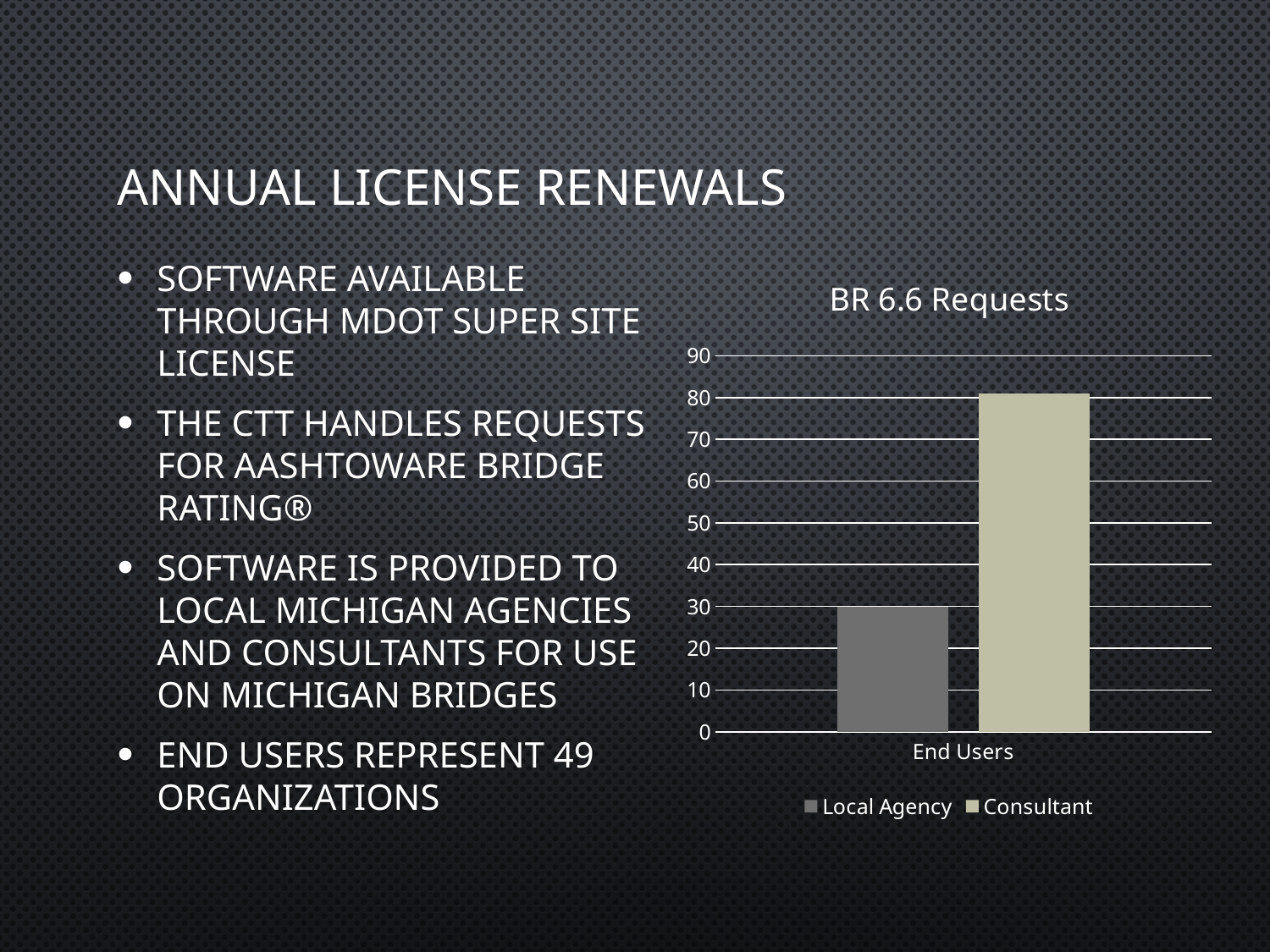
What is the category label on the x axis of the chart? End Users How many series does the chart legend list? 2 How many categories are shown on the x axis of the chart? 1 Which series has the higher value in the chart, Local Agency or Consultant? Consultant What is the value for Local Agency in the chart? 30 Which series has the highest value in the chart? Consultant Is the value for Consultant greater or less than 70? greater Is the value for Local Agency greater or less than 50? less What kind of chart is shown on the slide? bar chart What are the two series named in the chart legend? Local Agency and Consultant What is the title of the chart? BR 6.6 Requests Which series has the lowest value in the chart? Local Agency